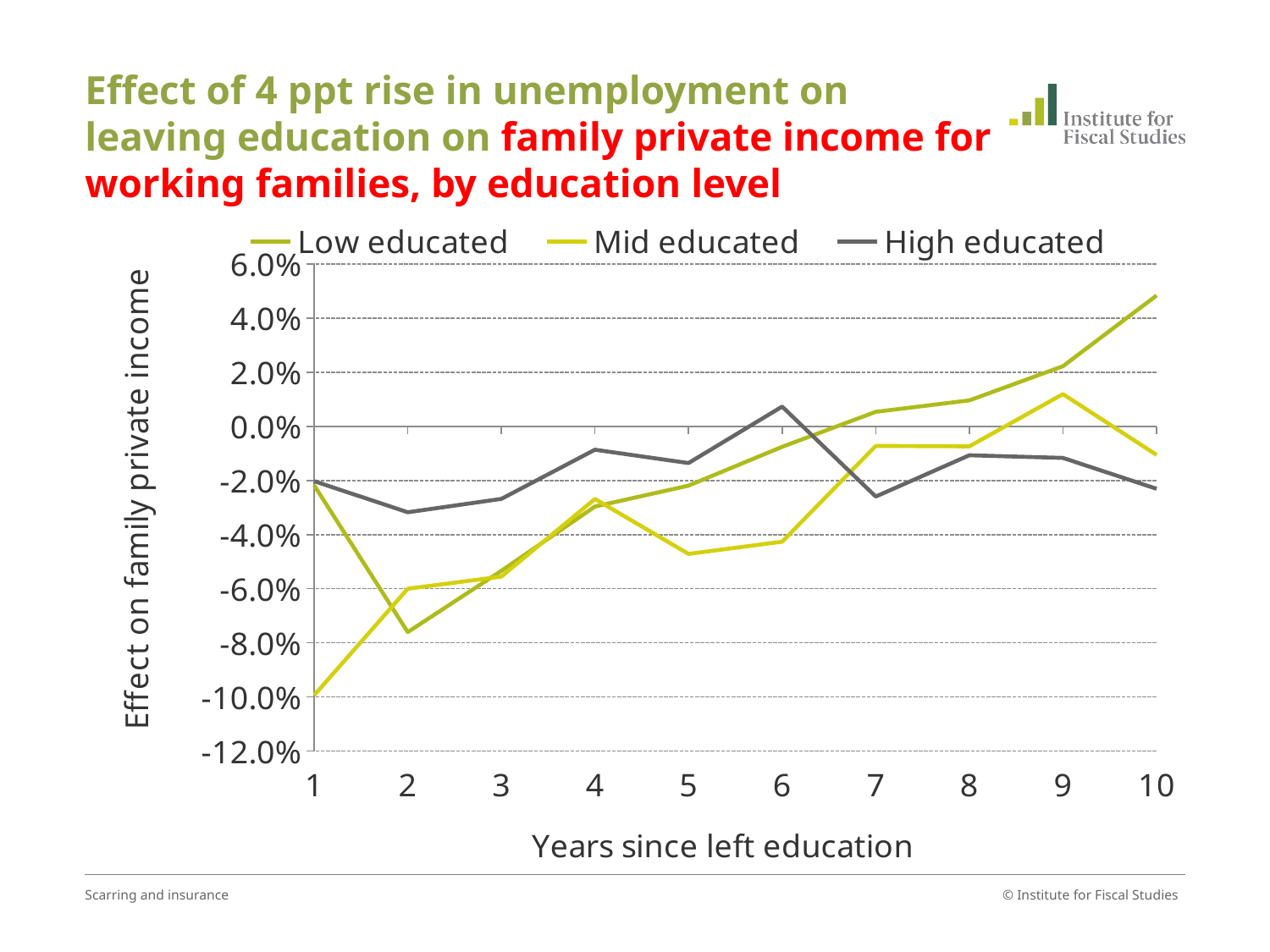
What kind of chart is shown on the slide? line chart Is the value for High educated at year 6 greater or less than 0.0%? greater Is the value for Mid educated at year 1 greater or less than -8.0%? less Does the Low educated line rise or fall overall from year 1 to year 10? rise Is the value for Mid educated at year 5 greater or less than -4.0%? less How many years are shown along the x axis? 10 At year 7, which is higher: High educated or Low educated? Low educated How many series does the legend list? 3 At year 2, which is higher: Low educated or Mid educated? Mid educated Which series has the highest value at year 10? Low educated Which series has the lowest value at year 1? Mid educated